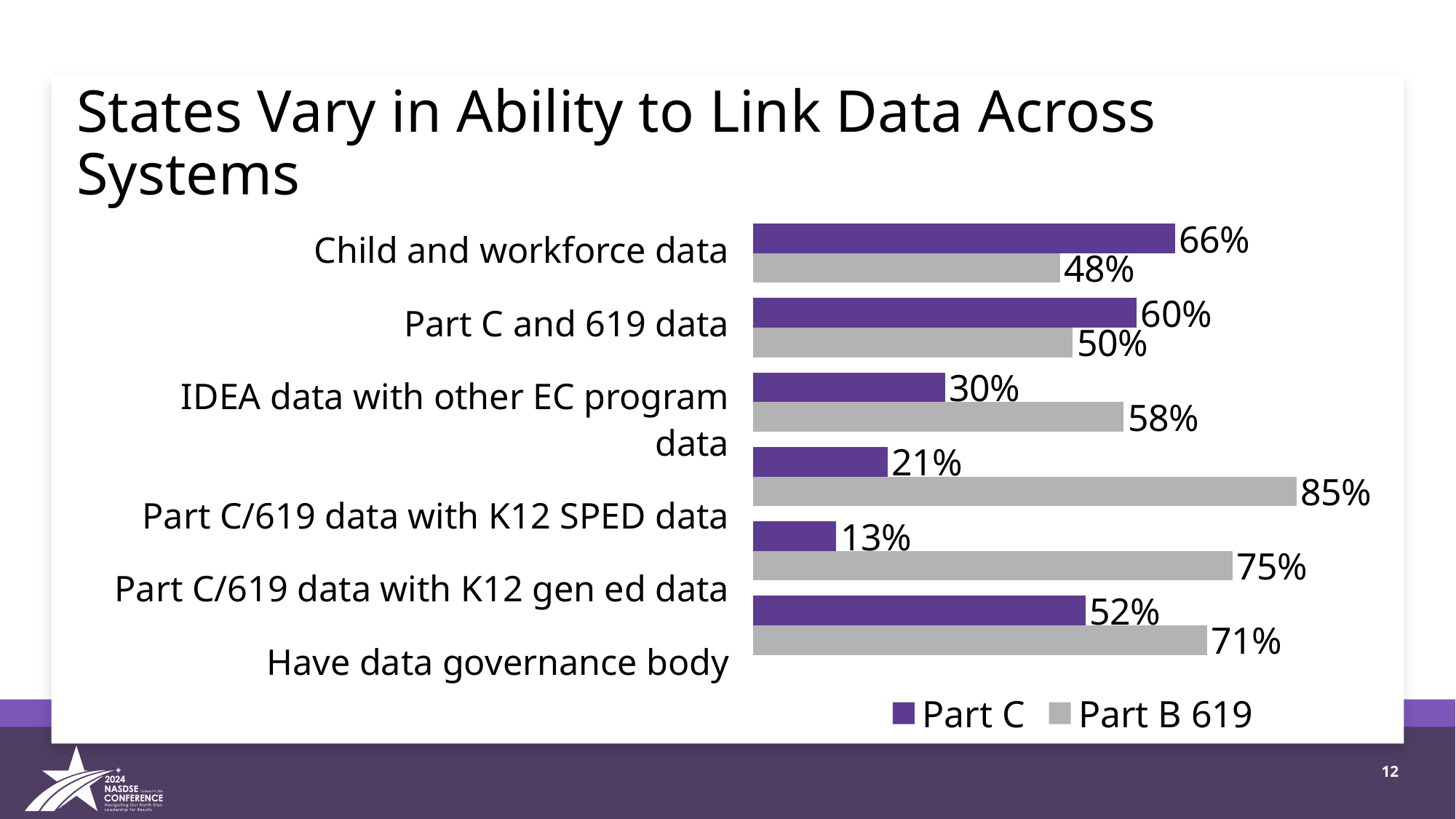
What kind of chart is shown on the slide? Bar chart For Part C and 619 data, which series has the larger value, Part C or Part B 619? Part C Which category has the highest Part B 619 value? Part C/619 data with K12 SPED data What is the Part C value for Child and workforce data? 66% What is the Part B 619 value for IDEA data with other EC program data? 58% What is the difference between the Part B 619 and Part C values for Have data governance body? 19% How many series does the legend list? 2 How many categories are shown in the chart? 6 What is the Part B 619 value for Part C/619 data with K12 SPED data? 85% What is the Part C value for Have data governance body? 52% Which category has the lowest Part C value? Part C/619 data with K12 gen ed data What is the difference between the Part C and Part B 619 values for Child and workforce data? 18%